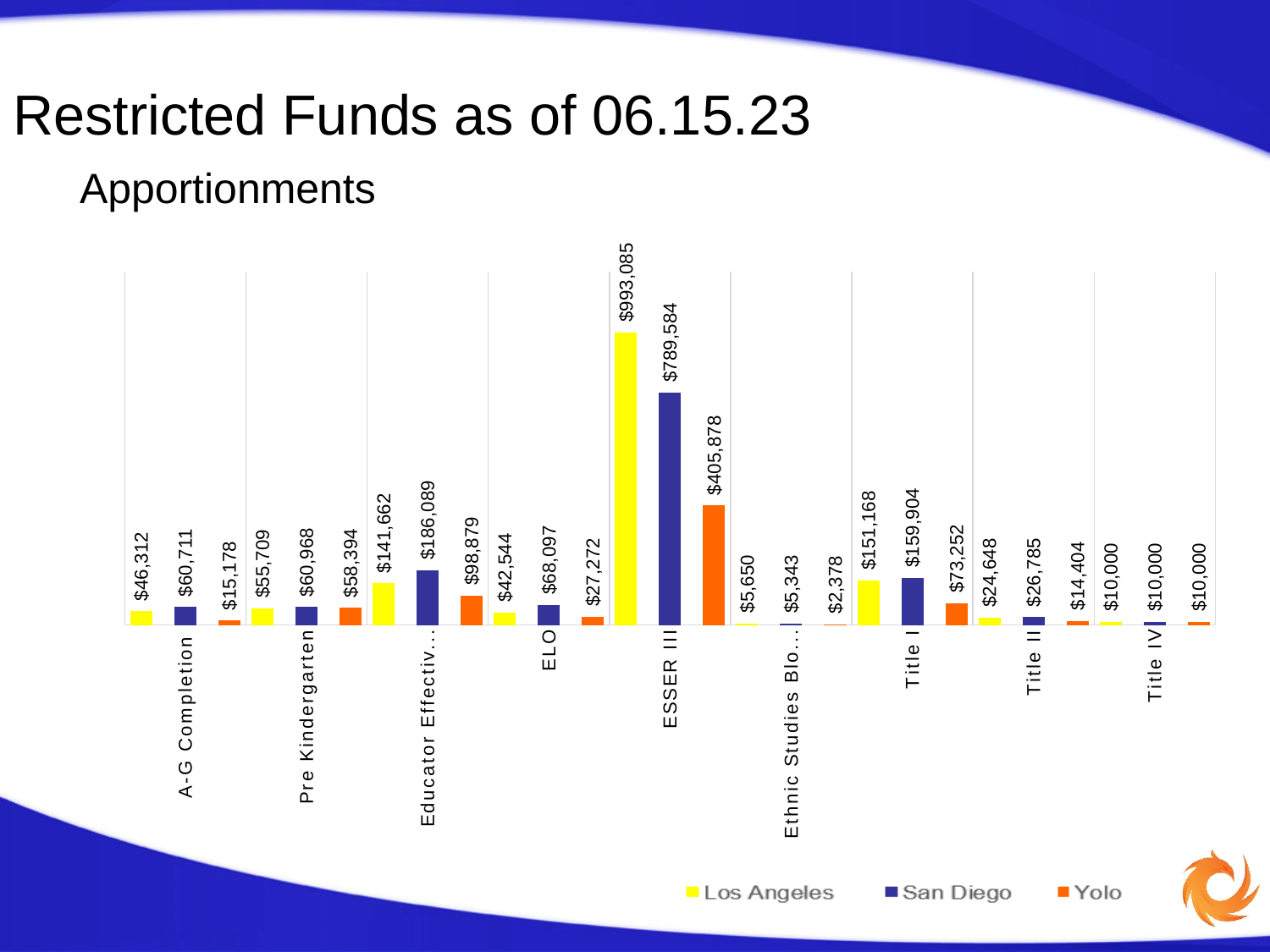
How many series does the legend list? 3 What is the Yolo value for Title I? $73,252 What is the difference between the Los Angeles and San Diego values for ESSER III? $203,501 What kind of chart is shown on the slide? Bar chart What is the Los Angeles value for A-G Completion? $46,312 What is the San Diego value for ELO? $68,097 Which category has the highest Los Angeles value? ESSER III What is the difference between the San Diego and Yolo values for ELO? $40,825 How many categories are shown on the x axis? 9 Which is larger for Pre Kindergarten, the San Diego value or the Yolo value? San Diego Which category has the lowest Yolo value? Ethnic Studies Blo... What is the Los Angeles value for ESSER III? $993,085